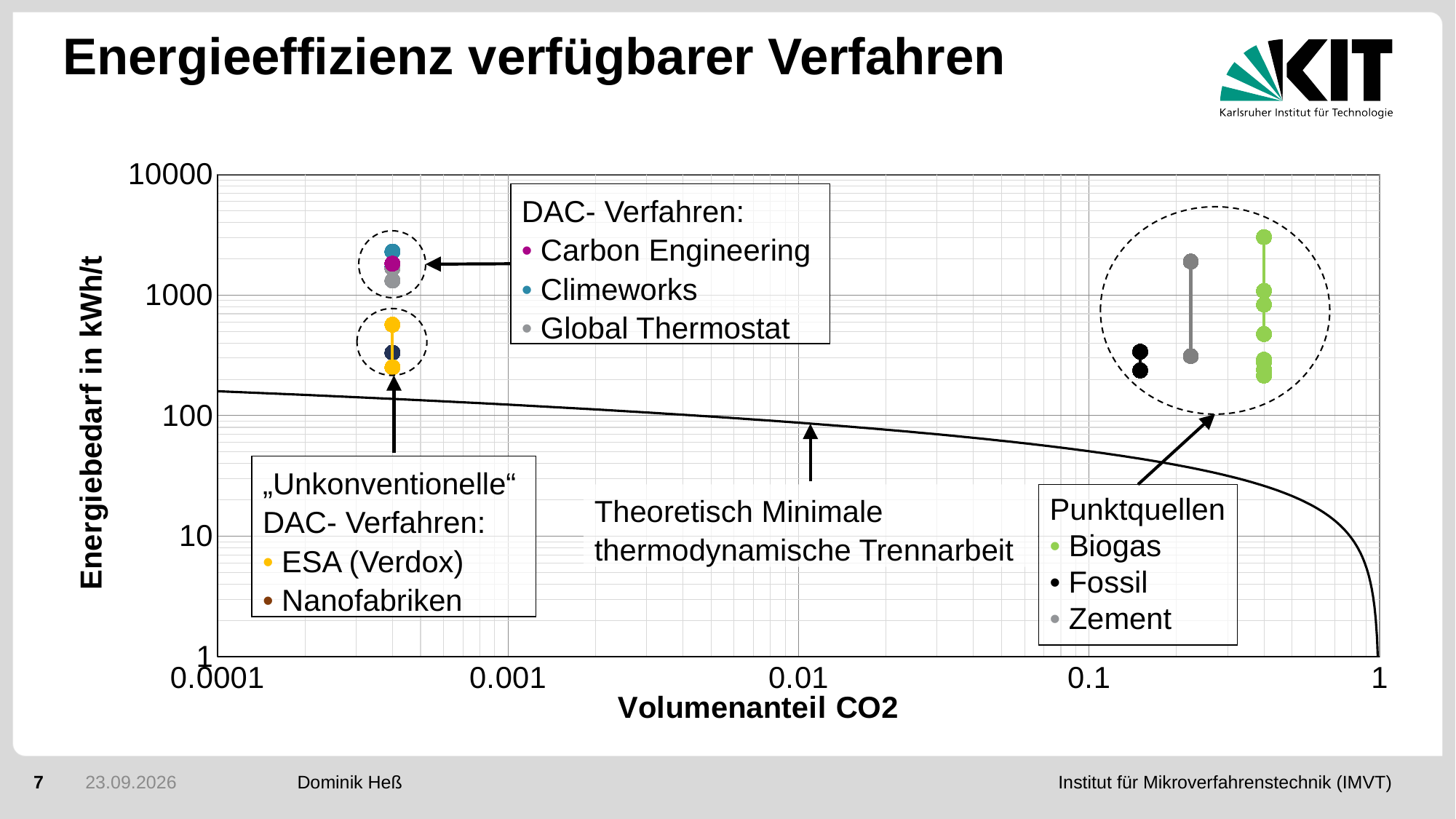
Does the curve for the theoretically minimal thermodynamic separation work rise or fall as the CO2 volume fraction increases? fall What is the title of the y axis of the chart? Energiebedarf in kWh/t Is the value for Nanofabriken greater or less than 1000 kWh/t? less Which has the higher energy demand, Climeworks or ESA (Verdox)? Climeworks What kind of chart is shown on the slide? scatter chart What is the title of the x axis of the chart? Volumenanteil CO2 Which of the Punktquellen reaches the highest energy demand? Biogas Are the values for Fossil greater or less than 1000 kWh/t? less Is the value for Nanofabriken greater or less than 100 kWh/t? greater How many DAC-Verfahren are listed in the 'DAC- Verfahren' legend box? 3